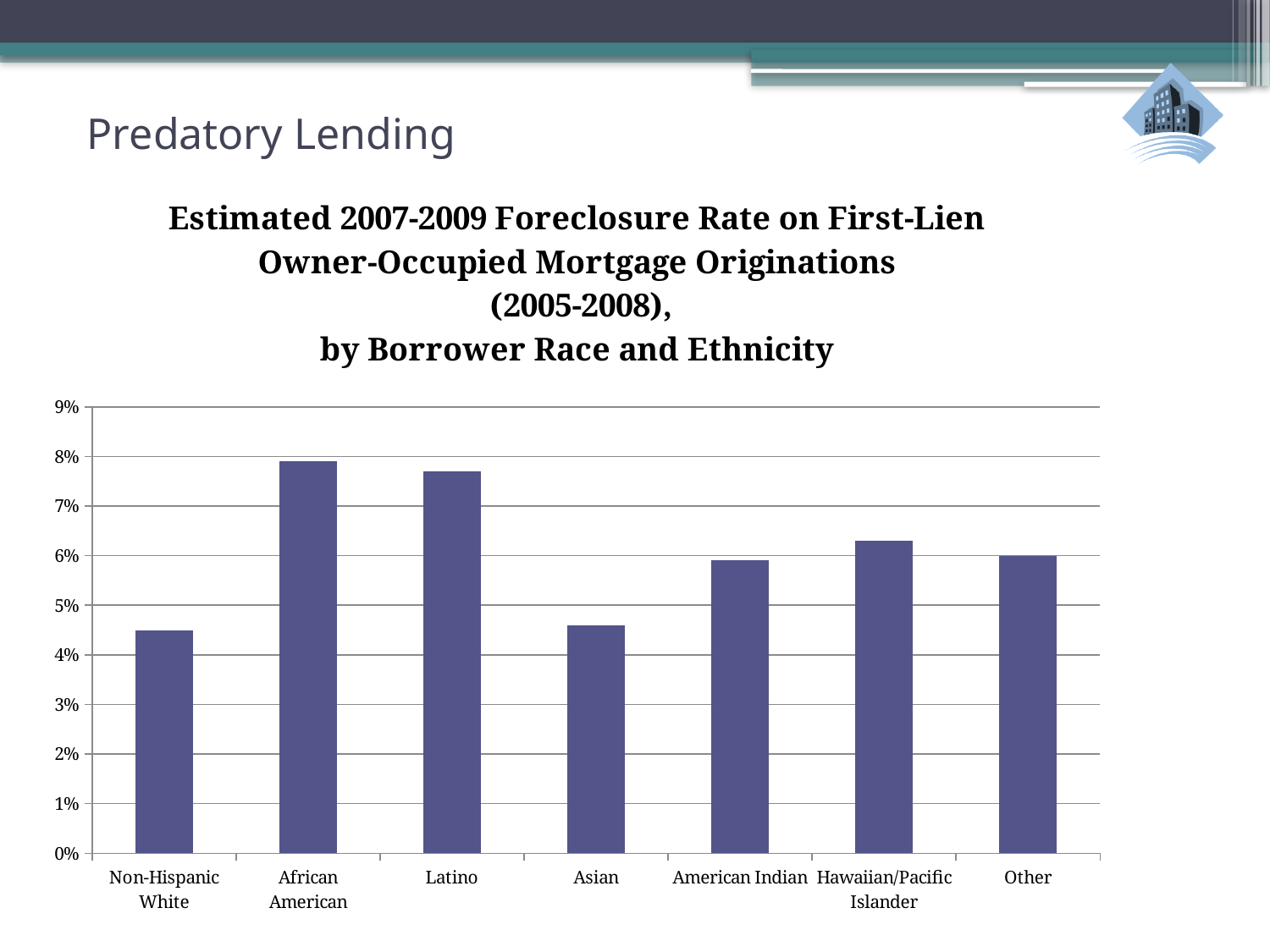
Is the value for Hawaiian/Pacific Islander greater or less than 6%? greater What kind of chart is shown on the slide? bar chart What is the highest value shown on the y axis? 9% How many borrower race/ethnicity categories are shown on the x axis? 7 Is the value for Non-Hispanic White greater or less than 5%? less Which category has the highest estimated foreclosure rate? African American Which has a higher foreclosure rate, African American or Asian? African American Is the value for Asian greater or less than 5%? less Which has a higher foreclosure rate, Hawaiian/Pacific Islander or American Indian? Hawaiian/Pacific Islander